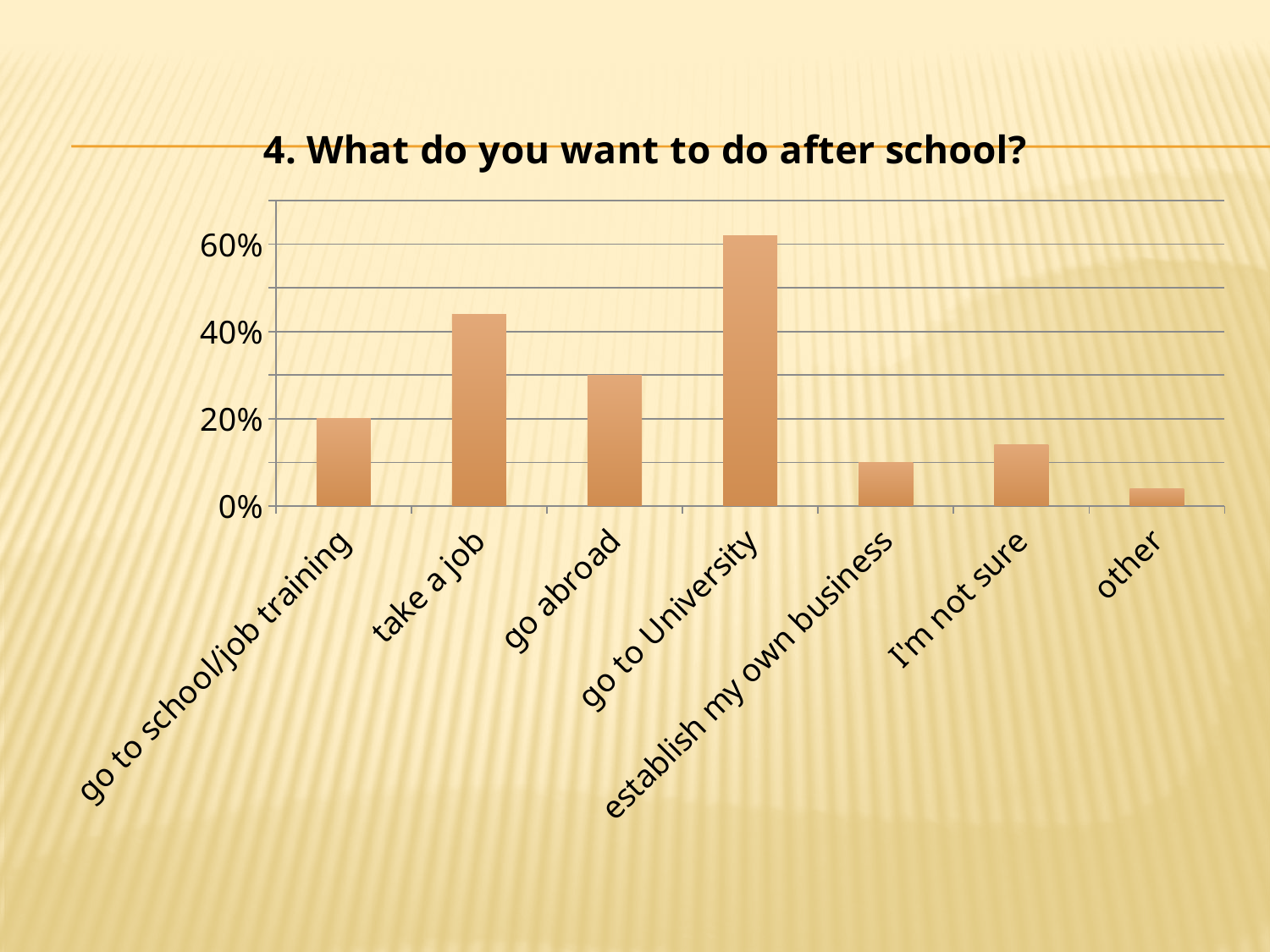
Which category has the lowest value in the chart? other What kind of chart is shown on the slide? bar chart Is the value for 'establish my own business' greater or less than 20%? less Is the value for 'take a job' greater or less than 40%? greater How many categories are shown on the x axis of the chart? 7 Is the value for 'go to University' greater or less than 40%? greater Which category has the highest value in the chart? go to University Which is larger, the value for 'I'm not sure' or the value for 'establish my own business'? I'm not sure What is the title of the chart? 4. What do you want to do after school? Which is larger, the value for 'take a job' or the value for 'go abroad'? take a job